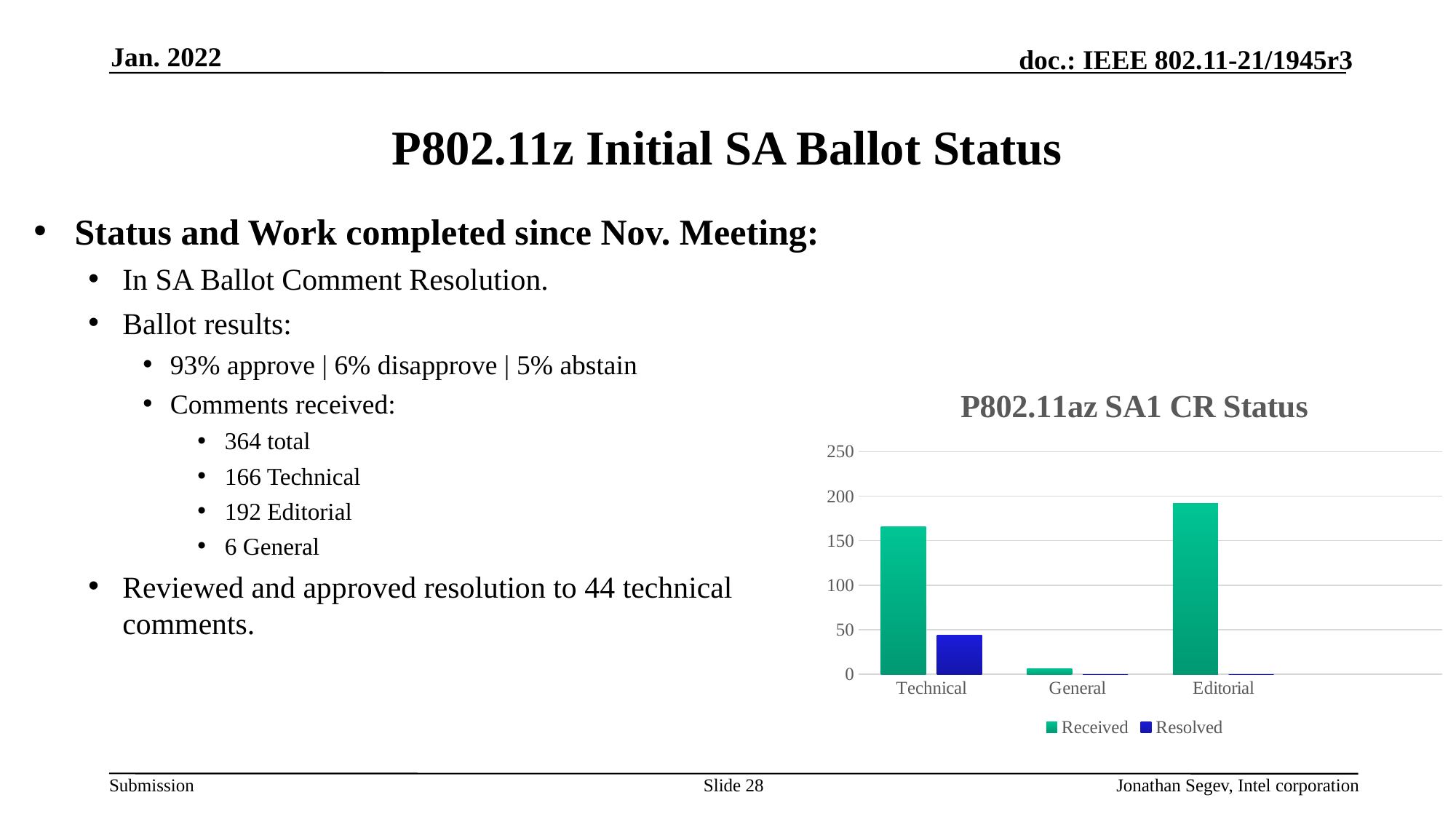
Which is larger, the Received value for Editorial or the Received value for Technical? Editorial Which category has the highest Received value? Editorial Which category has the highest Resolved value? Technical What kind of chart is shown on the slide? bar chart What is the title of the chart? P802.11az SA1 CR Status How many series does the chart legend list? 2 Is the Received value for Technical greater or less than 150? greater How many categories are shown on the x axis of the chart? 3 Is the Received value for General greater or less than 50? less Which category has the lowest Received value? General